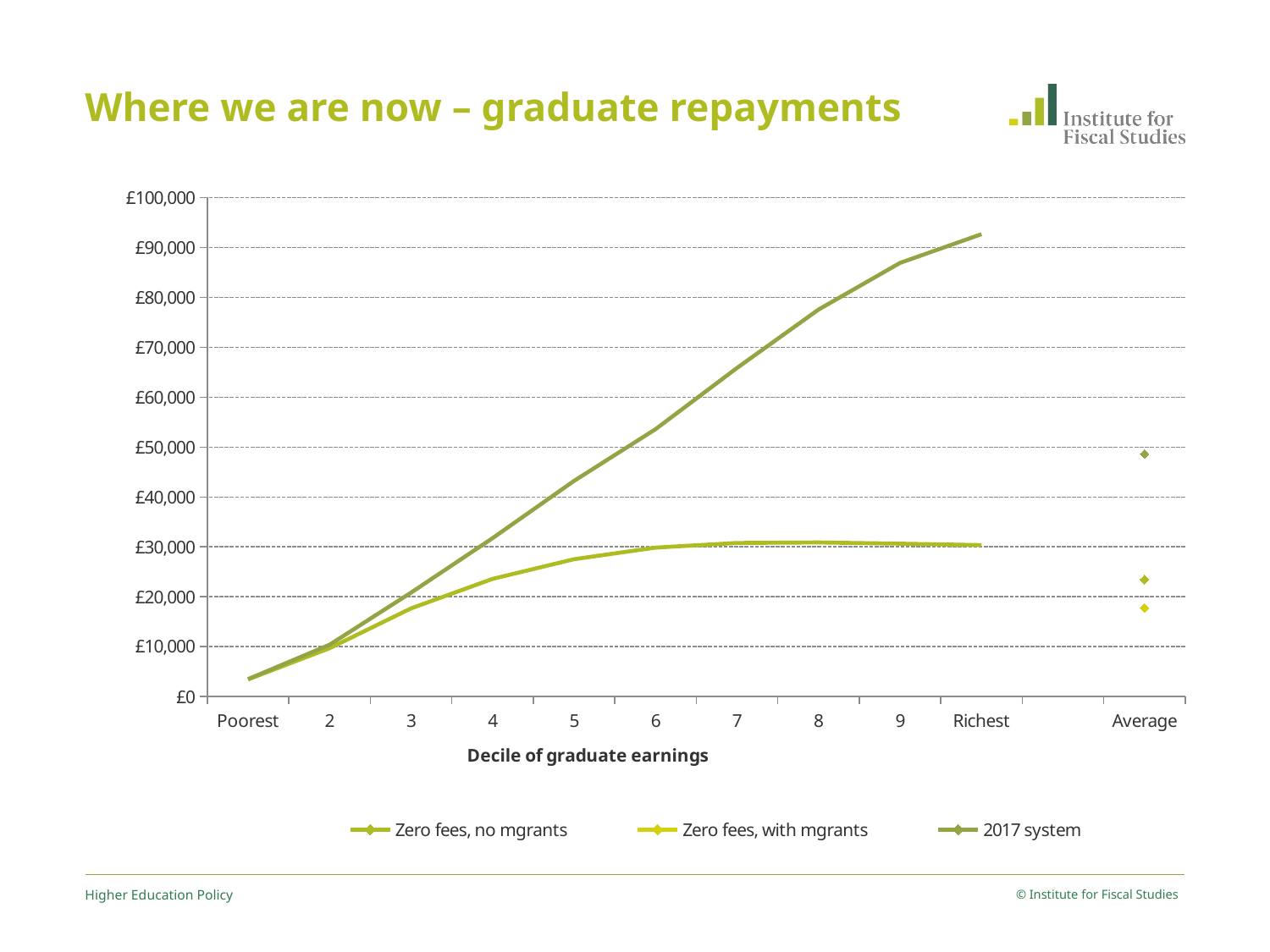
What kind of chart is shown on the slide? line chart Is the Average value for Zero fees, with mgrants greater or less than £20,000? less Does the 2017 system line rise or fall from Poorest to Richest? rise At Average, which series has the higher value: Zero fees, no mgrants or Zero fees, with mgrants? Zero fees, no mgrants Is the value for the 2017 system at decile 7 greater or less than £60,000? greater How many categories are shown along the x axis? 11 How many series does the legend list? 3 Is the value for the 2017 system at Richest greater or less than £90,000? greater What is the title of the x axis? Decile of graduate earnings At Richest, which series has the higher value: 2017 system or Zero fees, no mgrants? 2017 system